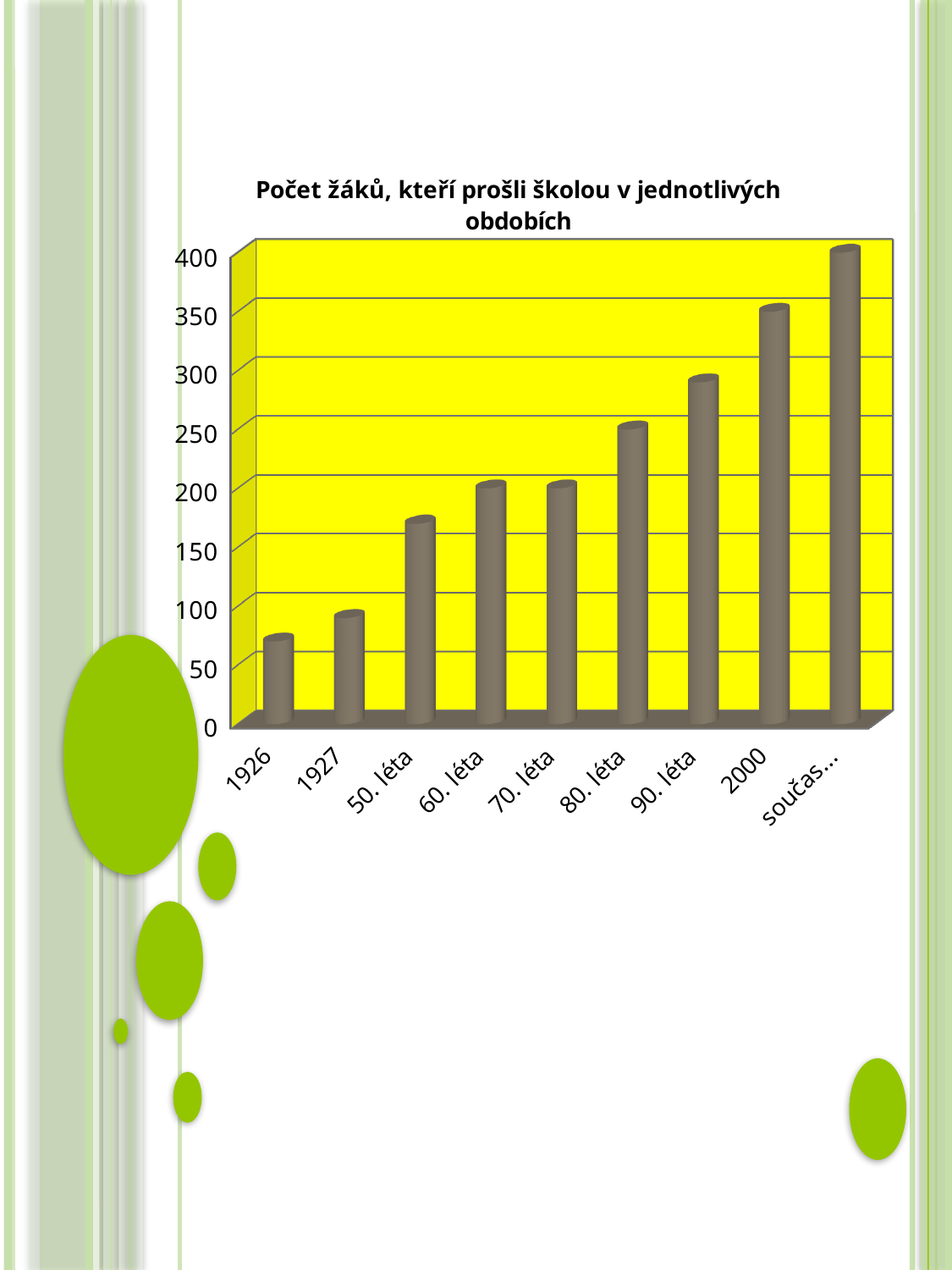
Which is larger, the value for 2000 or the value for 90. léta? 2000 How many categories (bars) are shown on the x axis? 9 Is the value for 80. léta greater or less than 200? greater Which category has the lowest value? 1926 Is the value for 2000 greater or less than 300? greater Is the value for 1926 greater or less than 50? greater Which bar is the tallest? the rightmost bar (součas...) What kind of chart is shown on the slide? bar chart What is the title of the chart? Počet žáků, kteří prošli školou v jednotlivých obdobích Do the values generally rise or fall from left to right along the x axis? rise